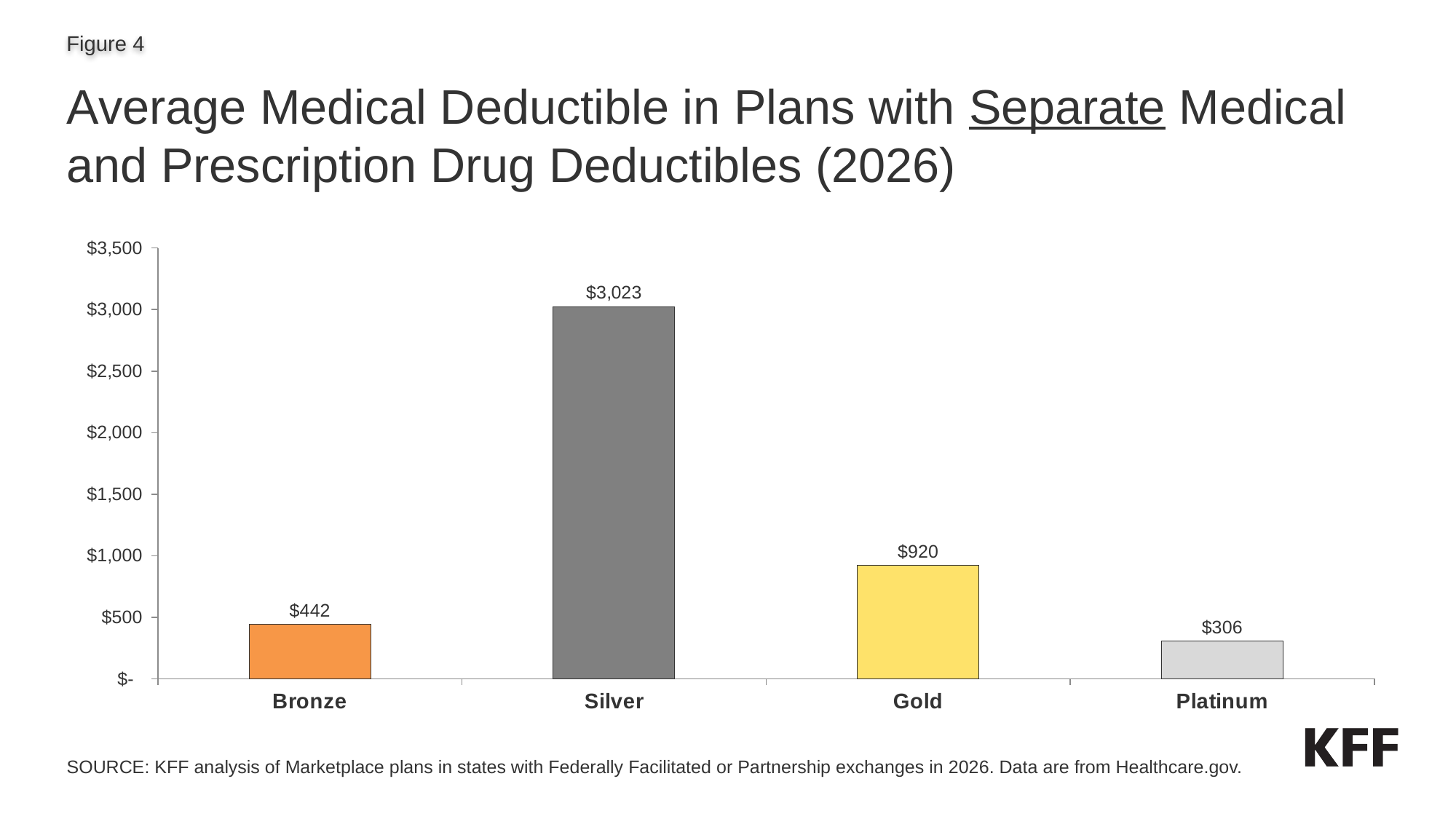
What is the difference between the average medical deductible for Silver and Gold plans? $2,103 Is the value for Silver greater or less than $3,000? greater What is the average medical deductible for Silver plans? $3,023 What is the average medical deductible for Platinum plans? $306 What is the difference between the average medical deductible for Bronze and Platinum plans? $136 What is the average medical deductible for Gold plans? $920 How many plan types are shown in the chart? 4 Which has a larger average medical deductible, Gold or Bronze? Gold What is the average medical deductible for Bronze plans? $442 What kind of chart is shown on the slide? Bar chart Which plan type has the highest average medical deductible? Silver Which plan type has the lowest average medical deductible? Platinum